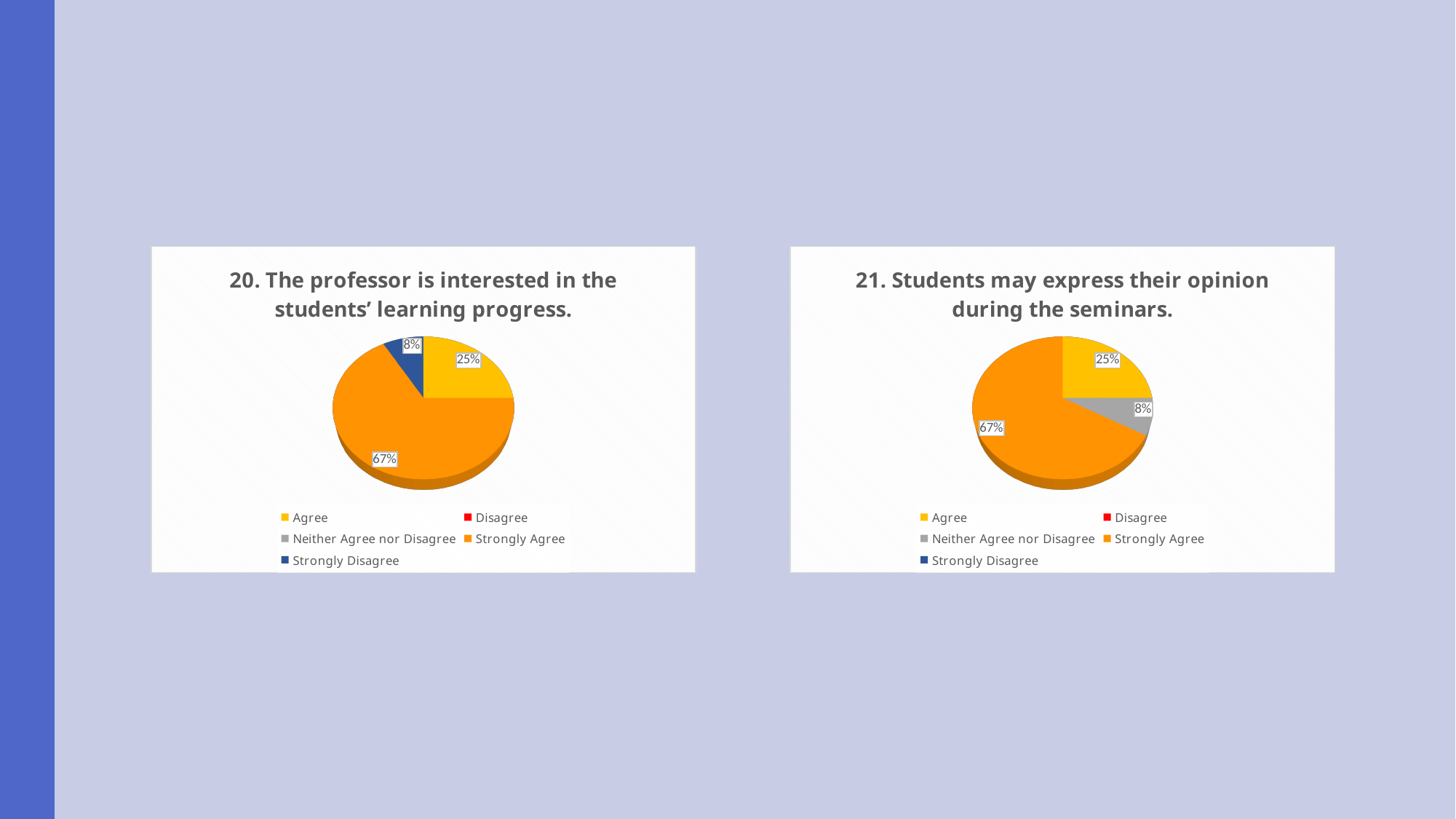
How many entries does the legend of the chart titled "20. The professor is interested in the students' learning progress." list? 5 In the chart titled "21. Students may express their opinion during the seminars.", what colour is the Strongly Agree slice? Orange In the chart titled "21. Students may express their opinion during the seminars.", what share of responses is Neither Agree nor Disagree? 8% In the chart titled "20. The professor is interested in the students' learning progress.", what share of responses is Strongly Disagree? 8% What kind of chart is the chart titled "21. Students may express their opinion during the seminars."? Pie chart In the chart titled "21. Students may express their opinion during the seminars.", what share of responses is Strongly Agree? 67% In the chart titled "21. Students may express their opinion during the seminars.", which response category has the smallest slice? Neither Agree nor Disagree In the chart titled "21. Students may express their opinion during the seminars.", what is the difference between the Strongly Agree share and the Agree share? 42% In the chart titled "20. The professor is interested in the students' learning progress.", which is larger: the Agree slice or the Strongly Disagree slice? Agree In the chart titled "20. The professor is interested in the students' learning progress.", which response category has the largest slice? Strongly Agree